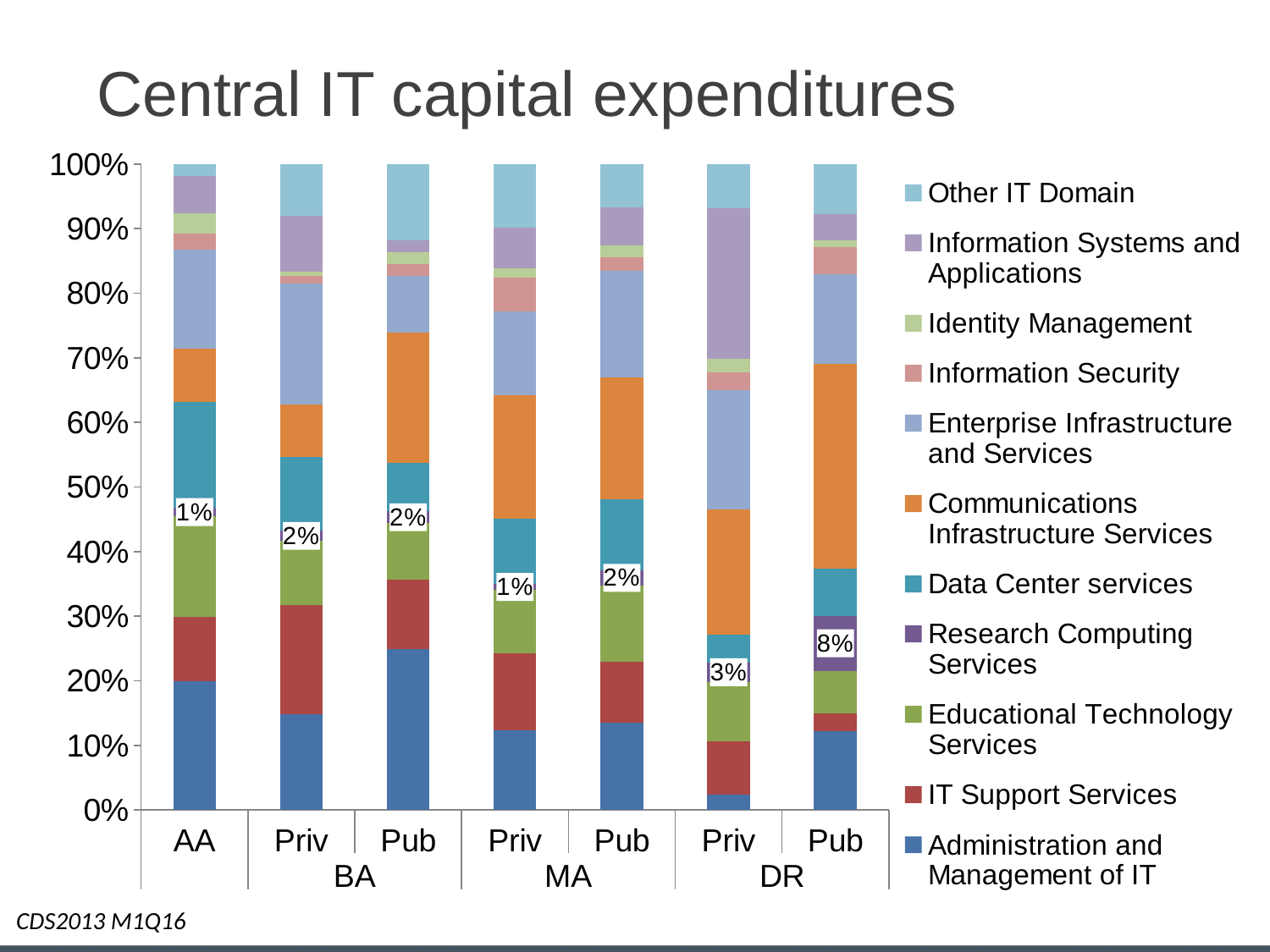
Which bar has the highest labeled share for Research Computing Services? DR Pub What is the difference between the Research Computing Services shares for DR Pub and DR Priv? 5 percentage points What is the title of the chart? Central IT capital expenditures What kind of chart is shown on the slide? Stacked bar chart Is the Administration and Management of IT share for DR Priv greater or less than 10%? less How many series does the legend list? 11 What is the labeled value for Research Computing Services in the DR Pub bar? 8% Is the Administration and Management of IT share for BA Pub greater or less than 20%? greater Which is larger, the Research Computing Services share for DR Pub or for DR Priv? DR Pub What is the labeled value for Research Computing Services in the BA Pub bar? 2% How many bars are plotted in the chart? 7 What is the labeled value for Research Computing Services in the DR Priv bar? 3%